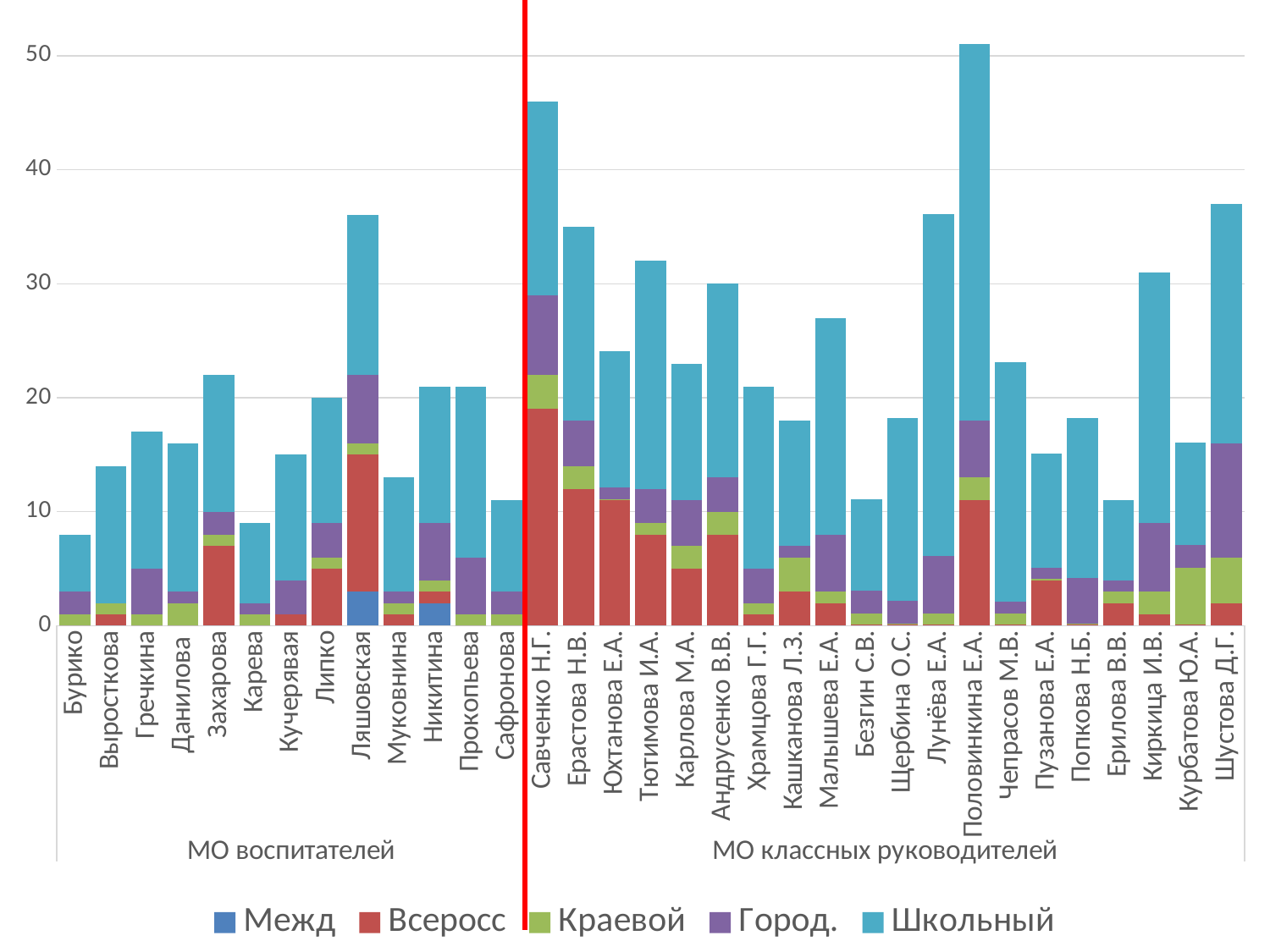
How many categories (people) are shown in the МО воспитателей group? 13 How many series does the legend list? 5 What are the two group labels shown below the category names? МО воспитателей and МО классных руководителей Which category has the tallest stacked bar overall? Половинкина Е.А. What kind of chart is shown on the slide? stacked bar chart Is the total bar height for Шустова Д.Г. greater or less than 30? greater Which series is shown in blue in the legend? Межд Is the total bar height for Карева greater or less than 10? less Which category has the shortest stacked bar overall? Бурико Which has the taller bar, Савченко Н.Г. or Ерастова Н.В.? Савченко Н.Г. Is the total bar height for Ляшовская greater or less than 30? greater How many categories (people) are shown in the МО классных руководителей group? 20